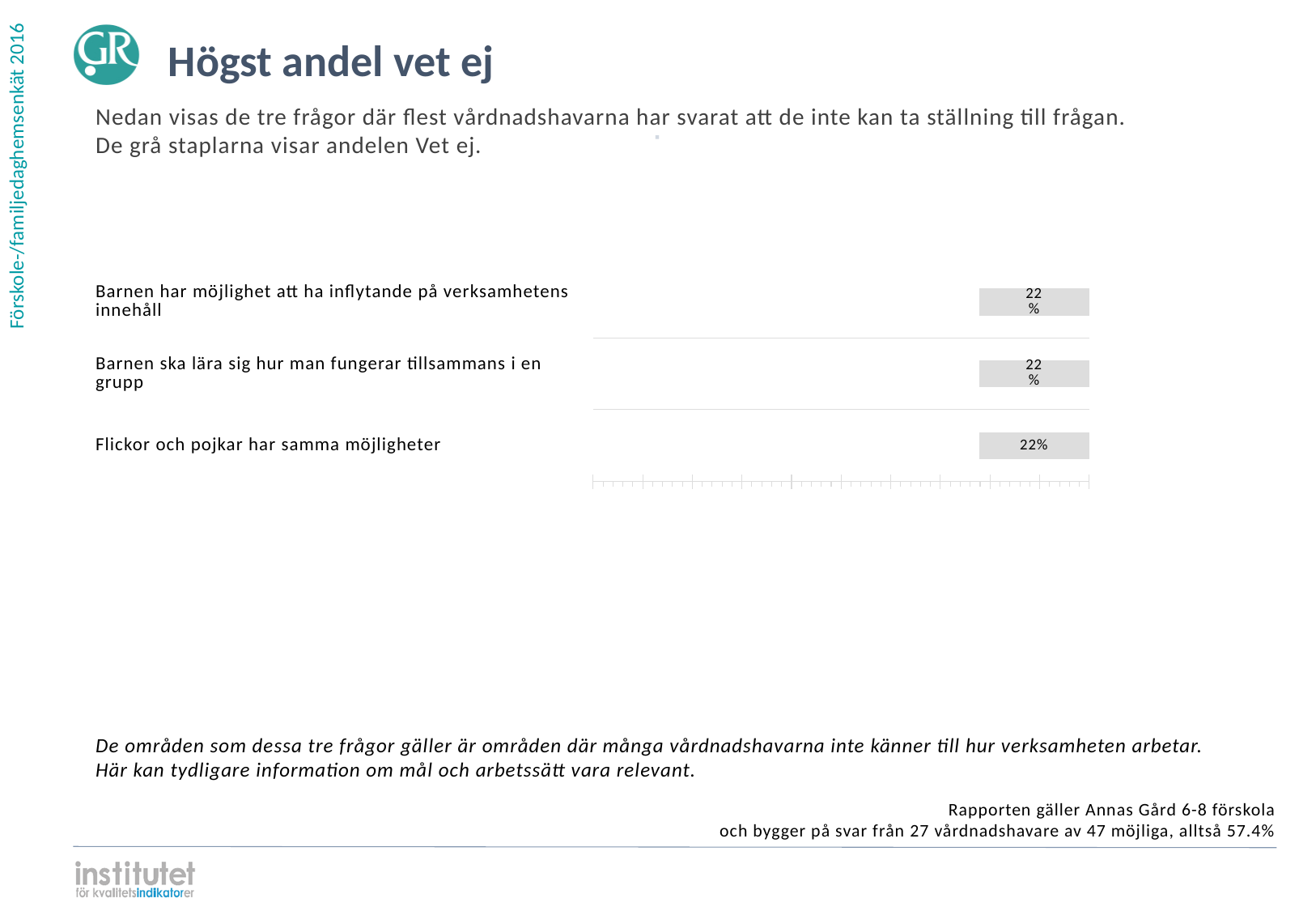
Do all three categories in the chart have the same value? Yes What is the value for "Flickor och pojkar har samma möjligheter"? 22% What is the value for "Barnen ska lära sig hur man fungerar tillsammans i en grupp"? 22% How many categories are shown in the chart? 3 What is the value for "Barnen har möjlighet att ha inflytande på verksamhetens innehåll"? 22% What kind of chart is shown on the slide? Bar chart What is the title of the slide containing the chart? Högst andel vet ej What is the difference between the value for "Flickor och pojkar har samma möjligheter" and the value for "Barnen ska lära sig hur man fungerar tillsammans i en grupp"? 0% What colour are the bars in the chart? Grey